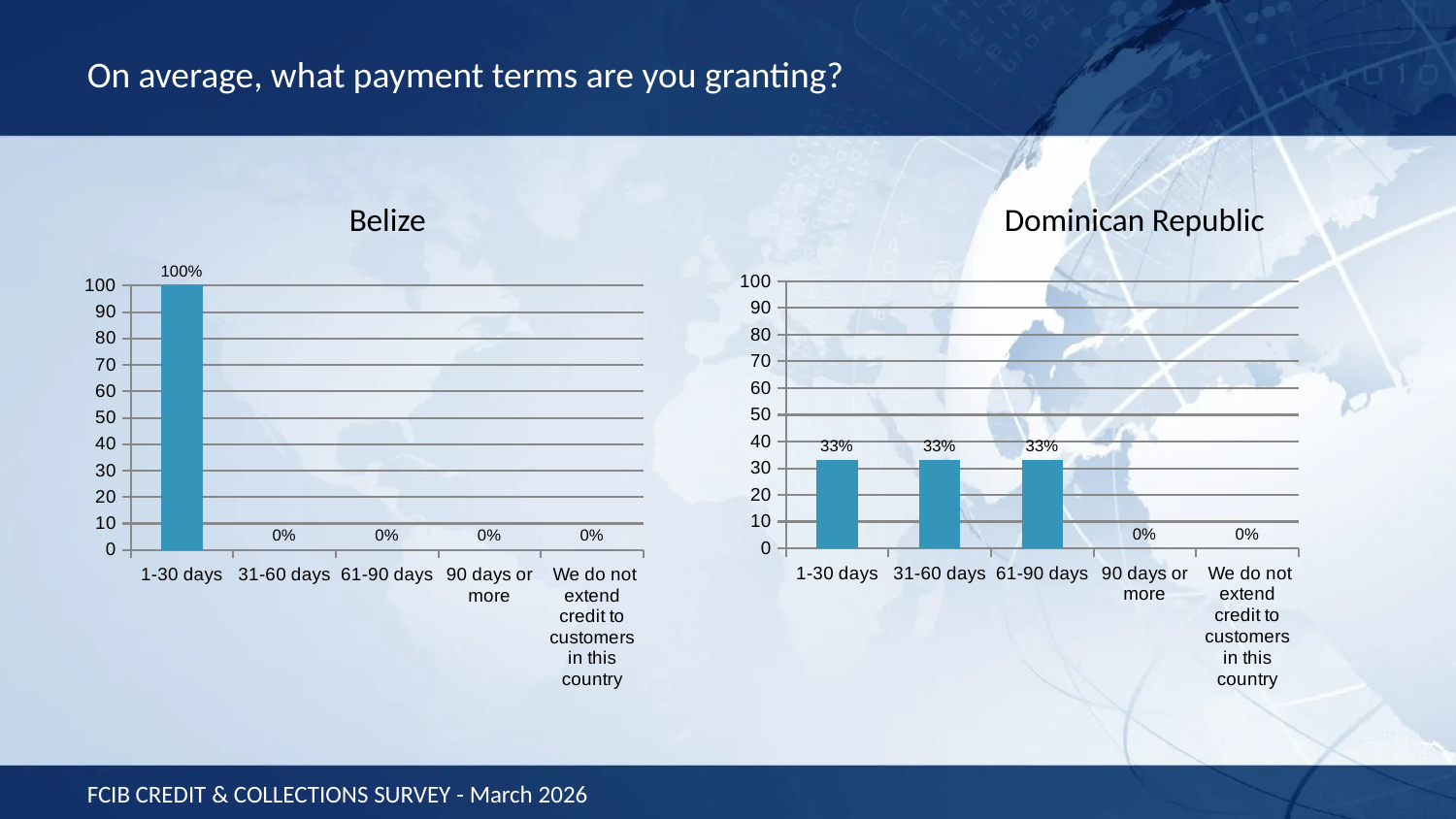
In the Dominican Republic chart, is the value for 1-30 days greater or less than 50? less What kind of chart is the Belize chart? bar chart In the Belize chart, what is the value for 1-30 days? 100% In the Dominican Republic chart, what is the difference between the value for 1-30 days and the value for 90 days or more? 33% In the Dominican Republic chart, which is larger, the value for 31-60 days or the value for 90 days or more? 31-60 days In the Belize chart, what is the value for 31-60 days? 0% What is the difference between the value for 1-30 days in the Belize chart and the value for 1-30 days in the Dominican Republic chart? 67% In the Dominican Republic chart, what is the value for 90 days or more? 0% In the Dominican Republic chart, what is the value for 61-90 days? 33% In the Belize chart, how many categories are shown on the x axis? 5 What is the title of the chart on the right side of the slide? Dominican Republic In the Belize chart, which category has the highest value? 1-30 days